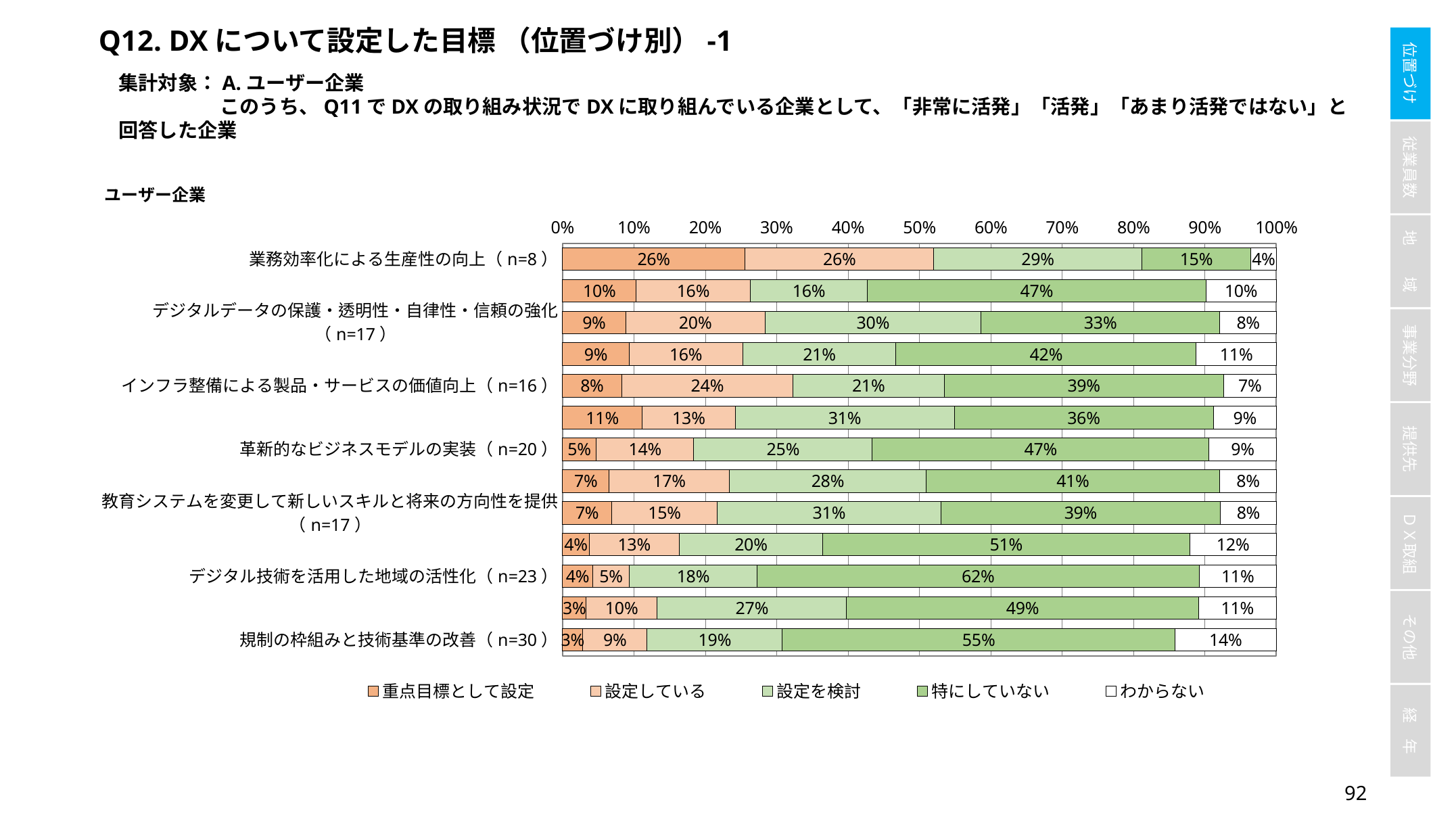
Which labeled category has the highest 特にしていない value? デジタル技術を活用した地域の活性化（n=23） What is the first entry in the legend? 重点目標として設定 What is the value of 設定を検討 for 革新的なビジネスモデルの実装（n=20）? 25% What is the value of 特にしていない for 規制の枠組みと技術基準の改善（n=30）? 55% What is the difference between the わからない value for 規制の枠組みと技術基準の改善（n=30） and for 業務効率化による生産性の向上（n=8）? 10 percentage points What is the value of 特にしていない for デジタル技術を活用した地域の活性化（n=23）? 62% What is the value of 設定を検討 for 教育システムを変更して新しいスキルと将来の方向性を提供（n=17）? 31% What kind of chart is shown on the slide? Stacked bar chart What is the value of 設定している for インフラ整備による製品・サービスの価値向上（n=16）? 24% How many series does the legend list? 5 Which has the larger 重点目標として設定 value: 業務効率化による生産性の向上（n=8） or 規制の枠組みと技術基準の改善（n=30）? 業務効率化による生産性の向上（n=8） What is the value of 重点目標として設定 for 業務効率化による生産性の向上（n=8）? 26%